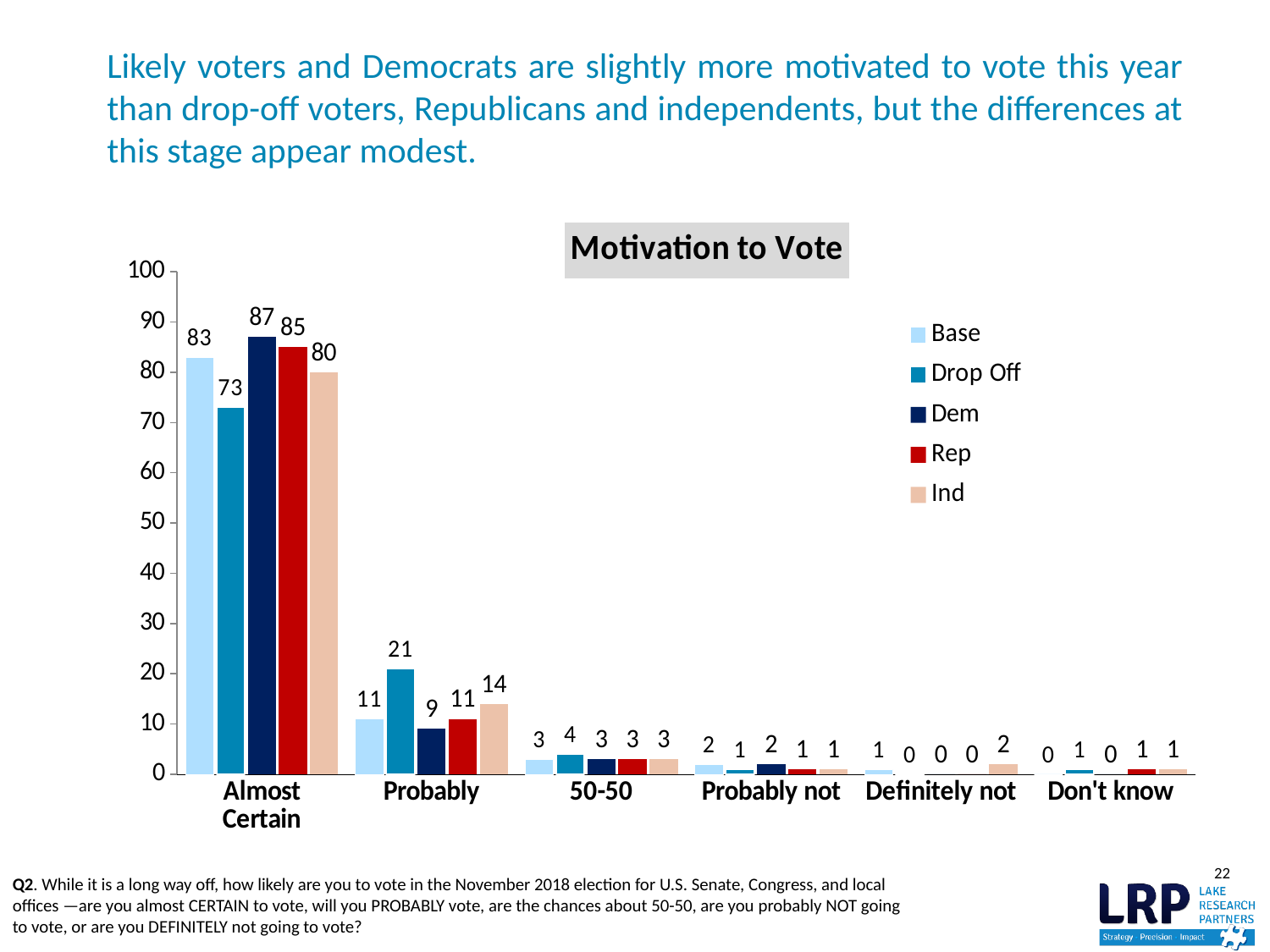
What is the value for Ind in the Almost Certain category? 80 What kind of chart is shown on the slide? Bar chart In the Probably category, which is larger: the Drop Off value or the Ind value? Drop Off How many series does the legend list? 5 How many categories are shown on the x axis? 6 What is the value for Dem in the Almost Certain category? 87 What is the title of the chart? Motivation to Vote Which series has the lowest value in the Almost Certain category? Drop Off Which series has the highest value in the Almost Certain category? Dem What is the value for Drop Off in the Probably category? 21 Is the value for Base in the Almost Certain category greater or less than 80? greater What is the difference between the Dem and Drop Off values in the Almost Certain category? 14